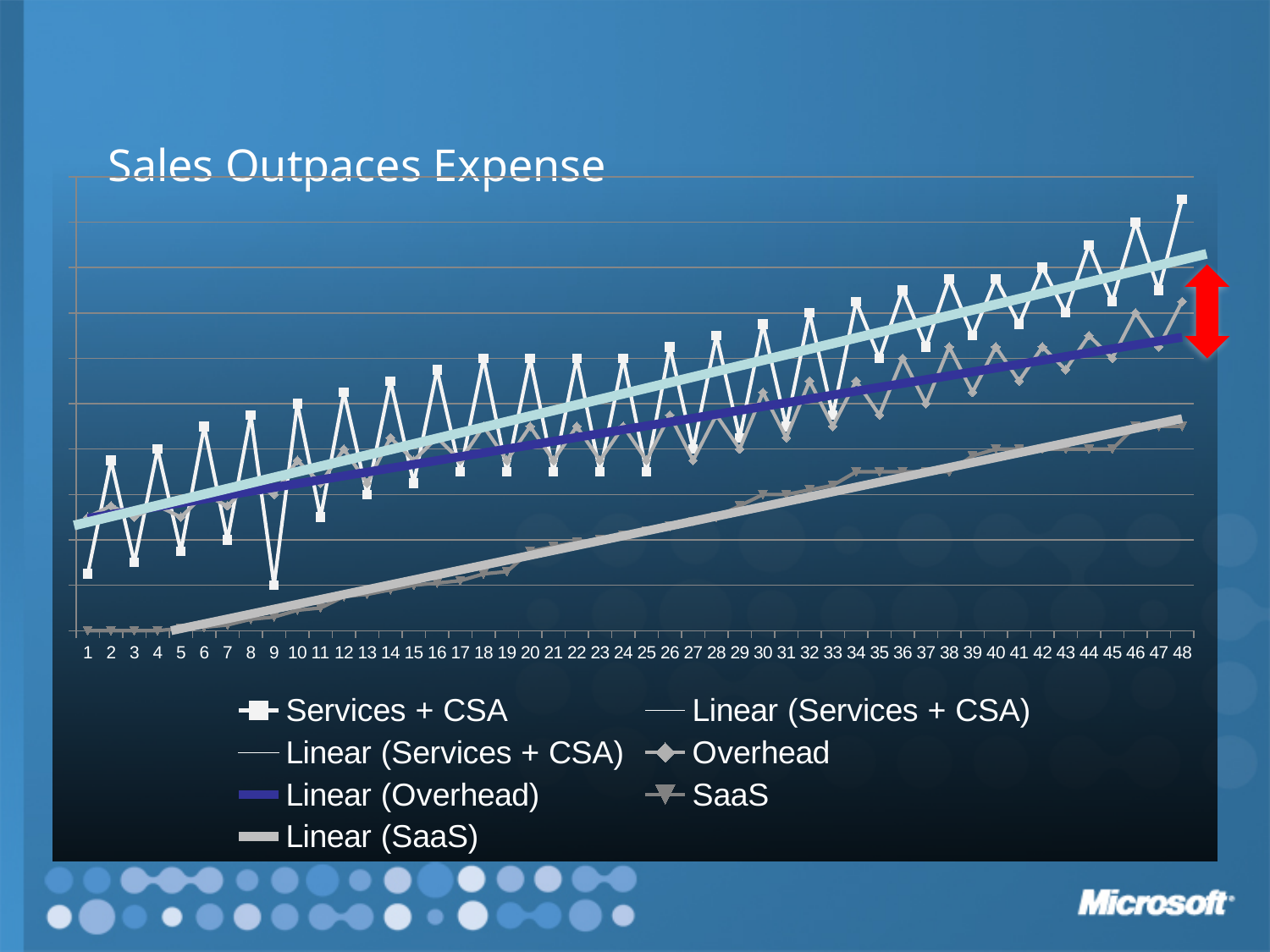
Which series has the highest value at point 48? Services + CSA How many entries does the chart's legend list? 7 Does the SaaS series generally rise or fall along the x axis? Rise At point 48, which is larger: Services + CSA or SaaS? Services + CSA What kind of chart is shown on the slide? Line chart What is the title of the chart? Sales Outpaces Expense How many points are plotted along the x axis of the chart? 48 Does the Overhead series generally rise or fall along the x axis? Rise Does the Services + CSA series generally rise or fall from point 1 to point 48? Rise At point 1, which is larger: Overhead or SaaS? Overhead Which series has the lowest value at point 48? SaaS Which series is drawn with a dark blue trend line according to the legend? Linear (Overhead)